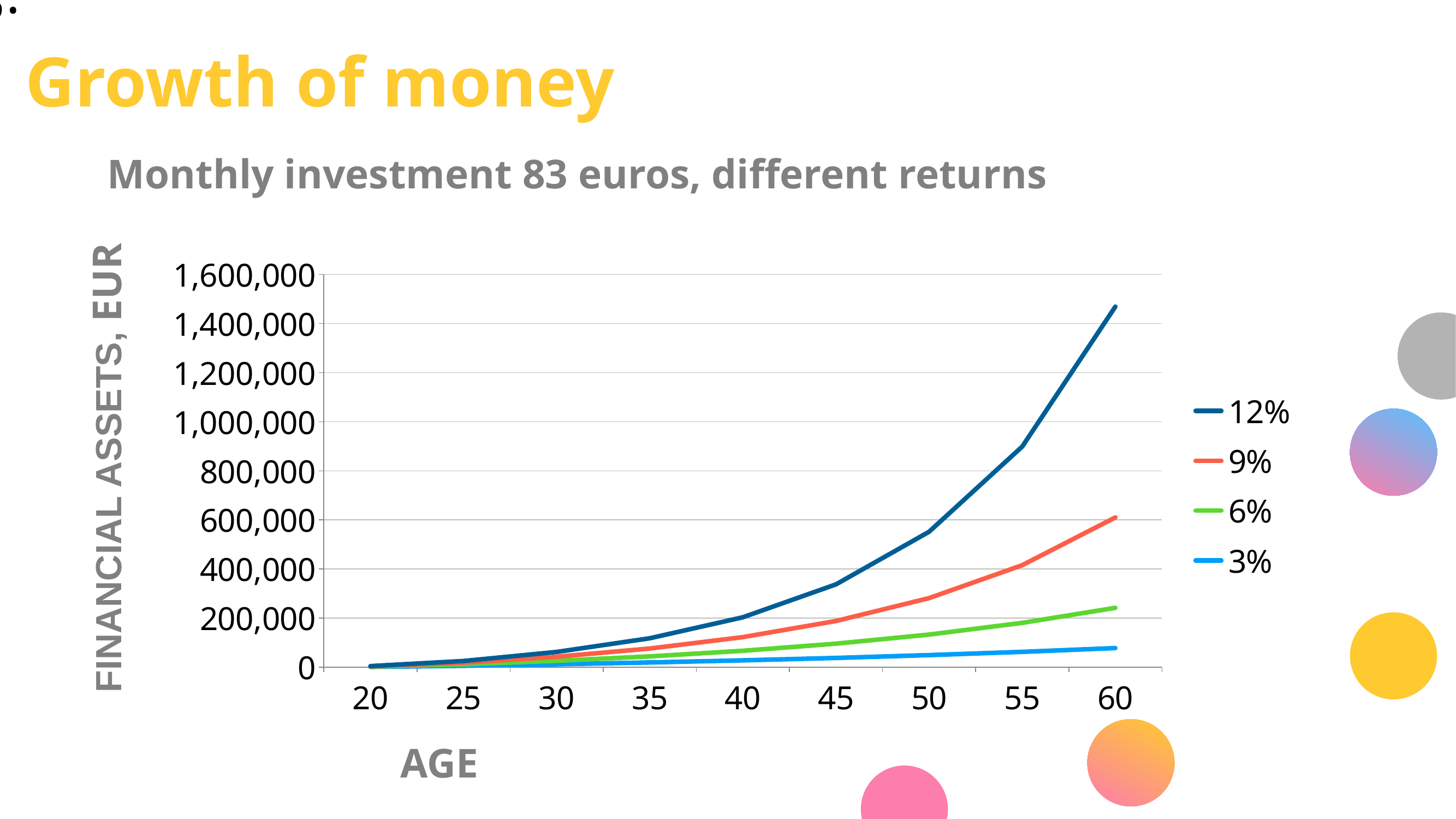
Is the value for the 12% series at age 50 greater or less than 400,000? greater What kind of chart is shown on the slide? line chart What is the title of the chart? Monthly investment 83 euros, different returns At age 60, which series has the larger value, 9% or 6%? 9% Is the value for the 12% series at age 60 greater or less than 1,200,000? greater Which series has the highest value at age 60? 12% Is the value for the 3% series at age 60 greater or less than 200,000? less How many series does the legend list? 4 Do the values of the 12% series rise or fall as age increases? rise How many age points are marked along the x axis? 9 Which series has the lowest value at age 60? 3%